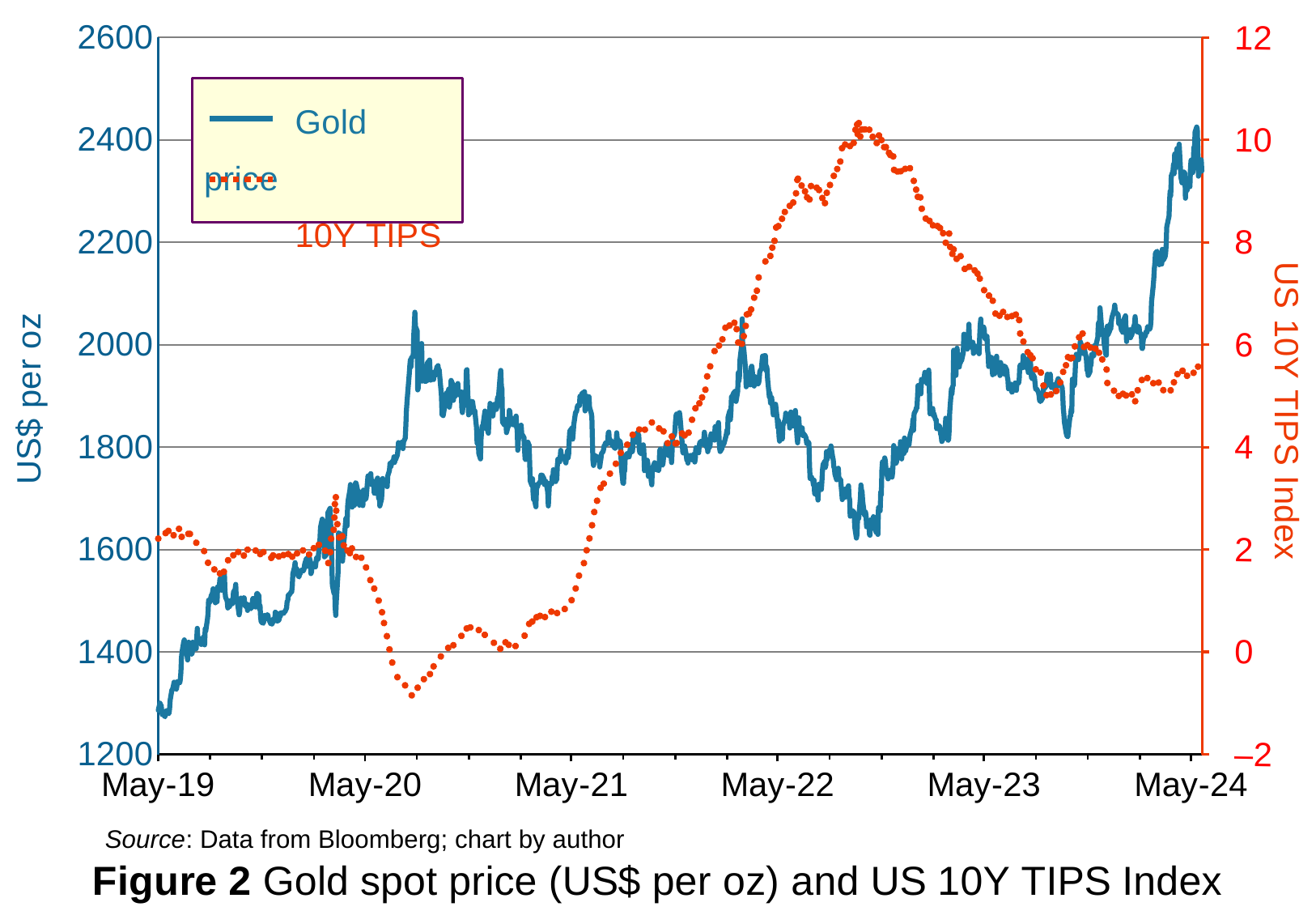
Does the Gold price overall rise or fall from May-19 to May-24? rise What is the title of the chart? Figure 2 Gold spot price (US$ per oz) and US 10Y TIPS Index Is the Gold price at May-19 greater or less than 1400? less Does the 10Y TIPS series rise or fall from May-20 to May-22? rise Is the Gold price at May-21 greater or less than 2000? less Is the Gold price at May-22 greater or less than 1800? greater What kind of chart is shown on the slide? Line chart How many series does the legend list? 2 What is the label of the left vertical axis? US$ per oz